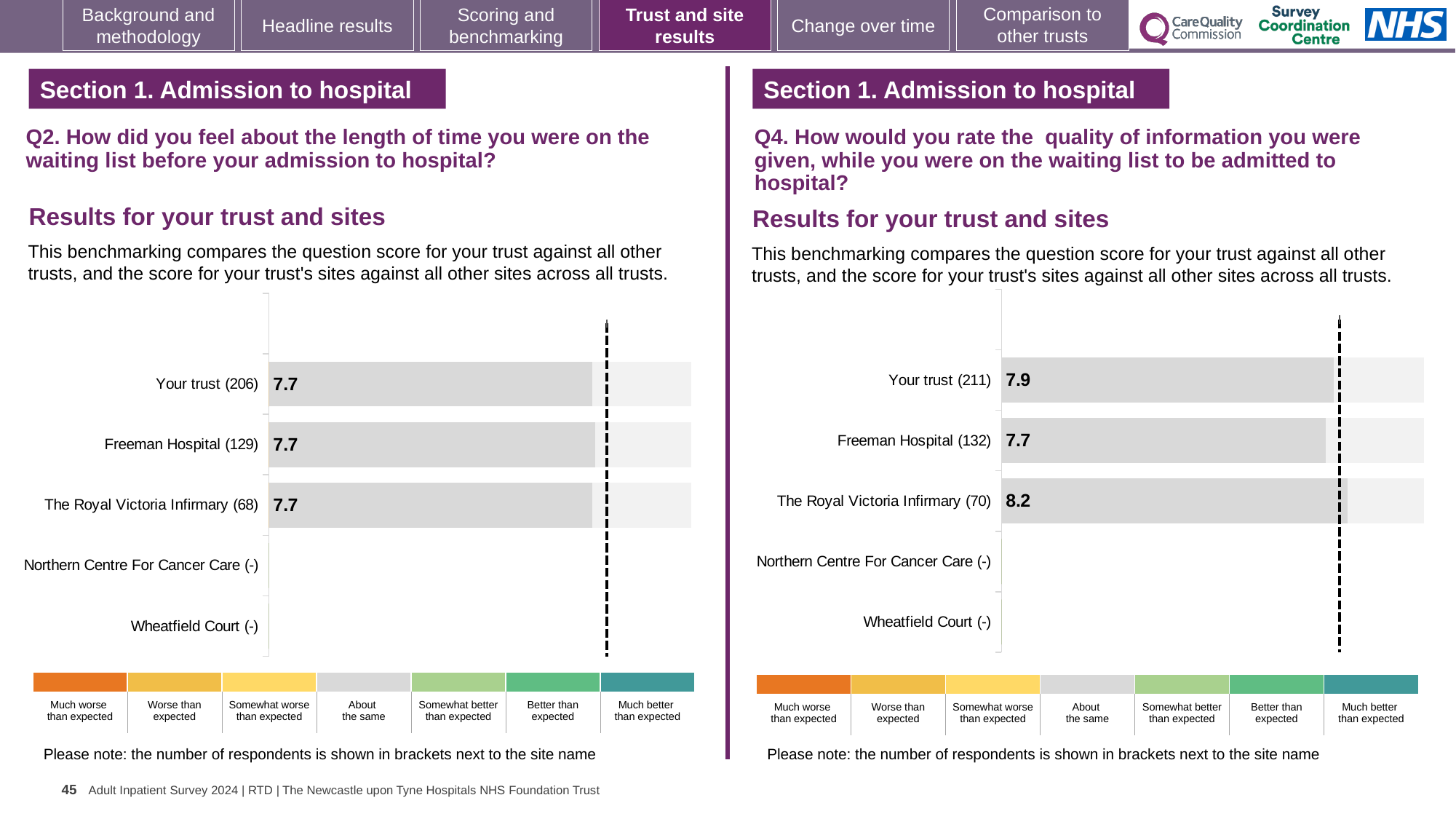
In the Q2 chart on the left, what is the score for Freeman Hospital? 7.7 What type of chart is the Q2 chart on the left? Bar chart In the Q2 chart on the left, how many respondents are shown in brackets for Your trust? 206 How many site/trust categories are listed on the Q2 chart on the left? 5 In the Q4 chart on the right, what is the score for Freeman Hospital? 7.7 In the Q4 chart on the right, what is the score for Your trust? 7.9 In the Q2 chart on the left, what is the score for Your trust? 7.7 In the Q4 chart on the right, which site has the lowest score among those with a score shown? Freeman Hospital In the Q4 chart on the right, what is the score for The Royal Victoria Infirmary? 8.2 In the Q4 chart on the right, which has the larger score, Your trust or The Royal Victoria Infirmary? The Royal Victoria Infirmary In the Q4 chart on the right, which site has the highest score? The Royal Victoria Infirmary In the Q4 chart on the right, what is the difference between the scores for The Royal Victoria Infirmary and Freeman Hospital? 0.5